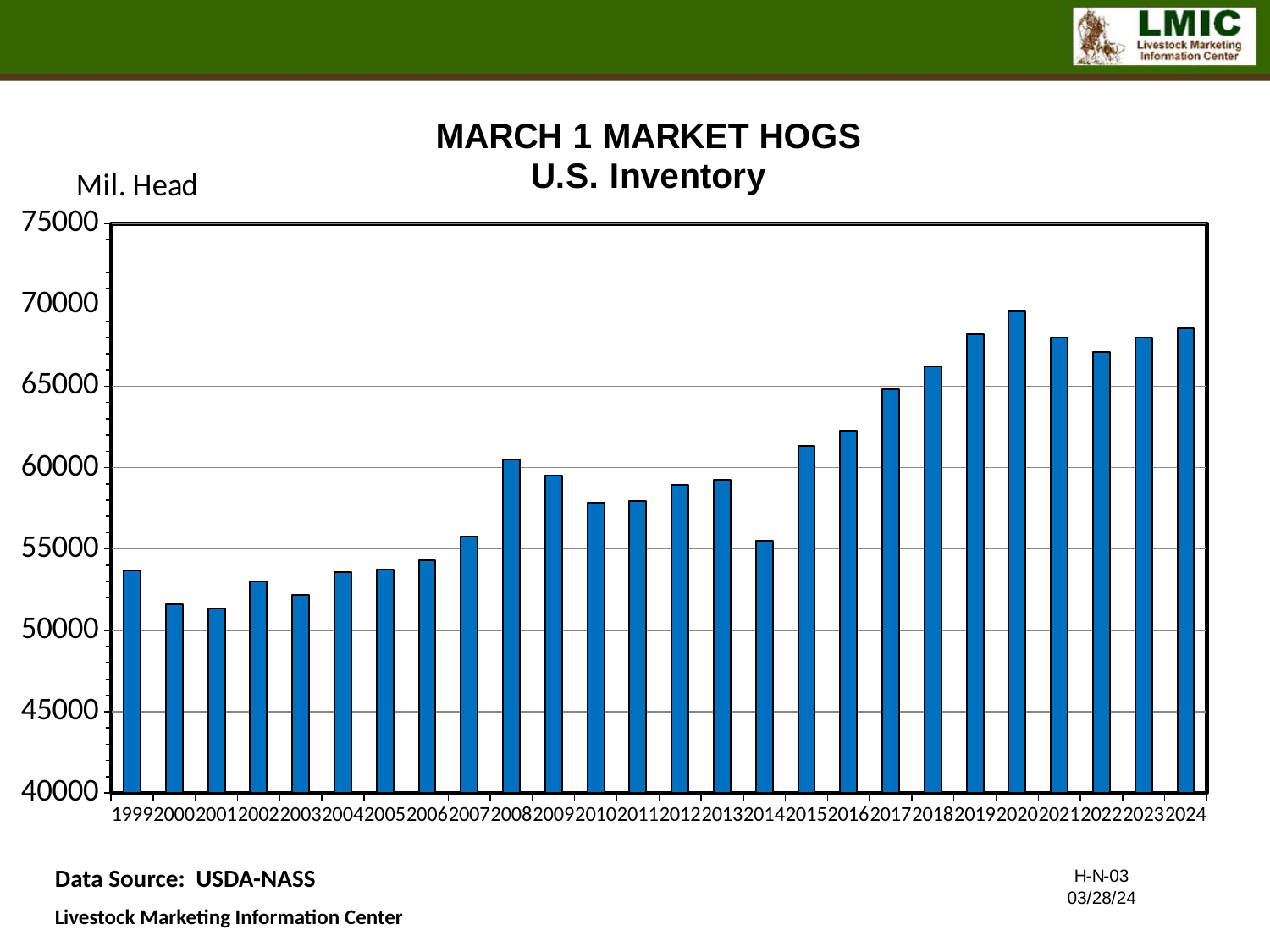
What kind of chart is shown on the slide? bar chart Is the value for 1999 greater or less than 55000? less Which is larger, the value for 2020 or the value for 2021? 2020 How many years (bars) are plotted on the chart? 26 Is the value for 2015 greater or less than 60000? greater Overall, do the values rise or fall from 1999 to 2024? rise Which is larger, the value for 2013 or the value for 2014? 2013 What is the data source cited for the chart? USDA-NASS Is the value for 2010 greater or less than 60000? less What unit is shown on the vertical axis label? Mil. Head Which year has the highest March 1 market hog inventory? 2020